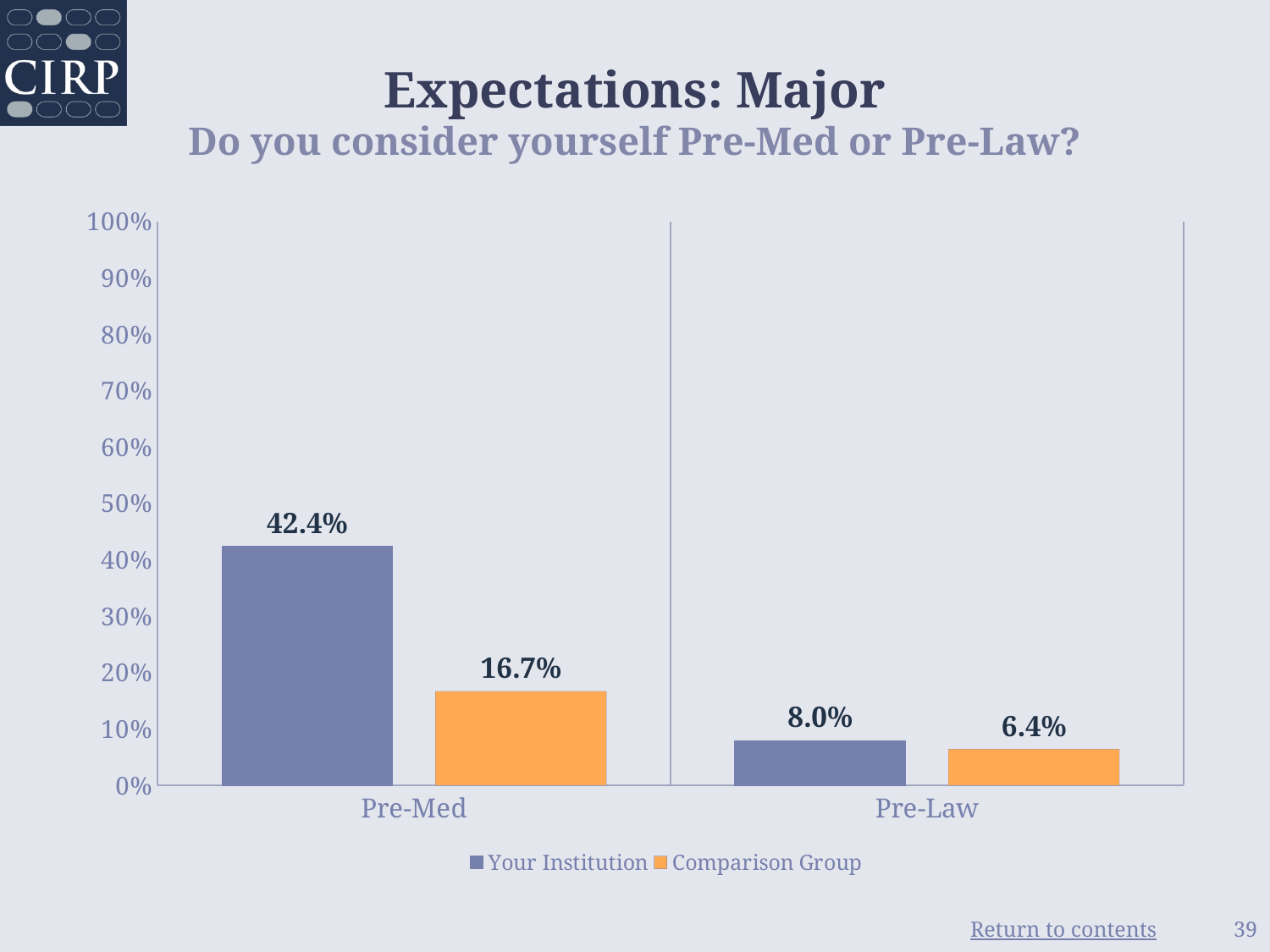
For Pre-Med, which is larger: Your Institution or the Comparison Group? Your Institution What is the Comparison Group value for Pre-Law? 6.4% What percentage of Your Institution students consider themselves Pre-Med? 42.4% How many series does the legend list? 2 Which bar has the highest value on the chart? Your Institution, Pre-Med What is the difference between Your Institution and the Comparison Group for Pre-Law? 1.6% How many categories are shown on the x axis? 2 What is the difference between Your Institution and the Comparison Group for Pre-Med? 25.7% Which bar has the lowest value on the chart? Comparison Group, Pre-Law What kind of chart is shown on the slide? Bar chart What is the Your Institution value for Pre-Law? 8.0% What is the Comparison Group value for Pre-Med? 16.7%